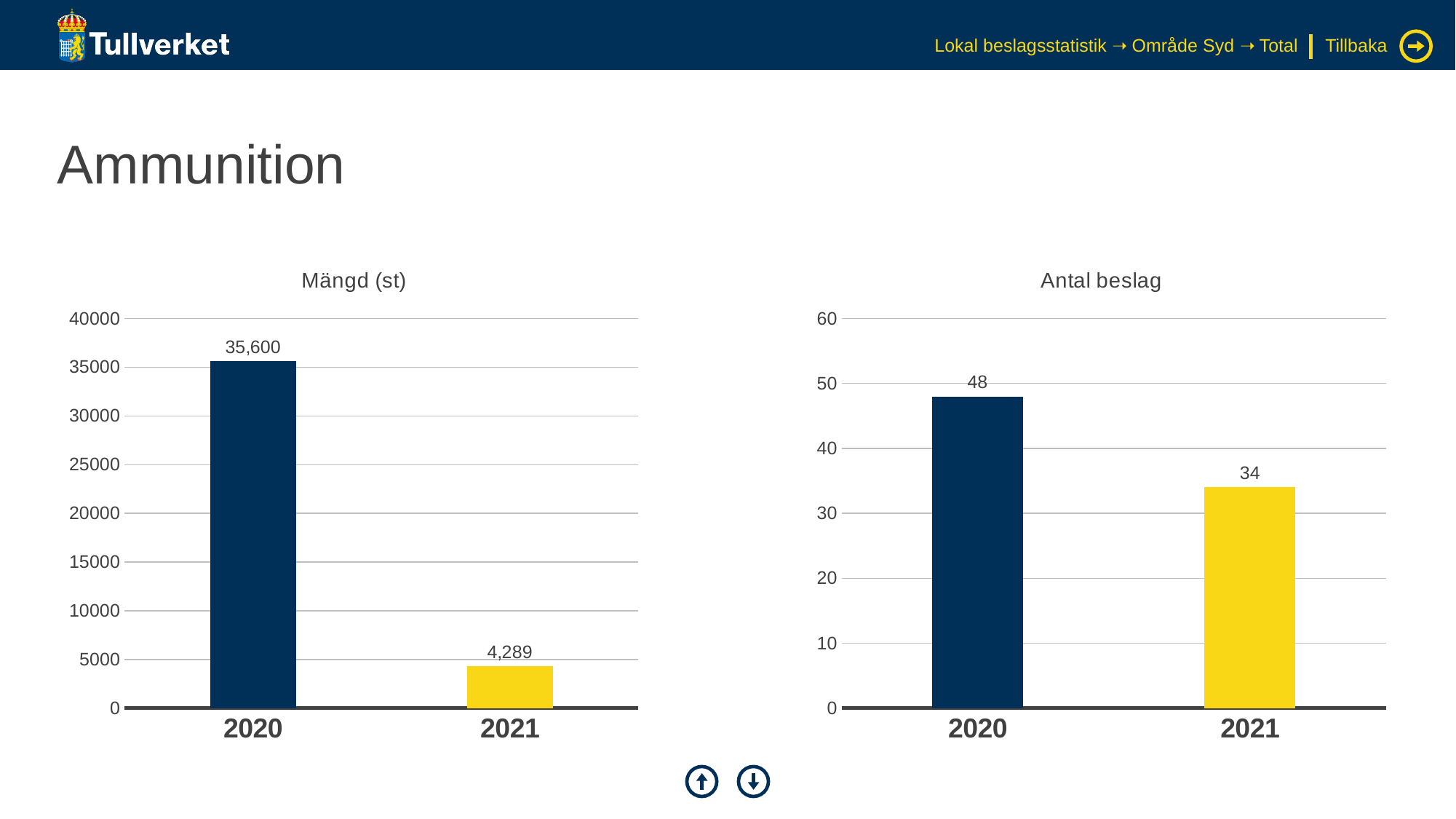
In the 'Antal beslag' chart, which year has the lowest value? 2021 In the 'Mängd (st)' chart, which year has the highest value? 2020 In the 'Mängd (st)' chart, what is the value for 2021? 4,289 What kind of chart is the 'Antal beslag' chart? bar chart In the 'Antal beslag' chart, is the value for 2020 greater or less than 40? greater In the 'Antal beslag' chart, what is the value for 2021? 34 In the 'Antal beslag' chart, what is the difference between the 2020 and 2021 values? 14 In the 'Mängd (st)' chart, how many years are shown on the x axis? 2 In the 'Antal beslag' chart, what is the value for 2020? 48 In the 'Mängd (st)' chart, what is the difference between the 2020 and 2021 values? 31,311 In the 'Mängd (st)' chart, what is the value for 2020? 35,600 In the 'Antal beslag' chart, do the values rise or fall from 2020 to 2021? fall